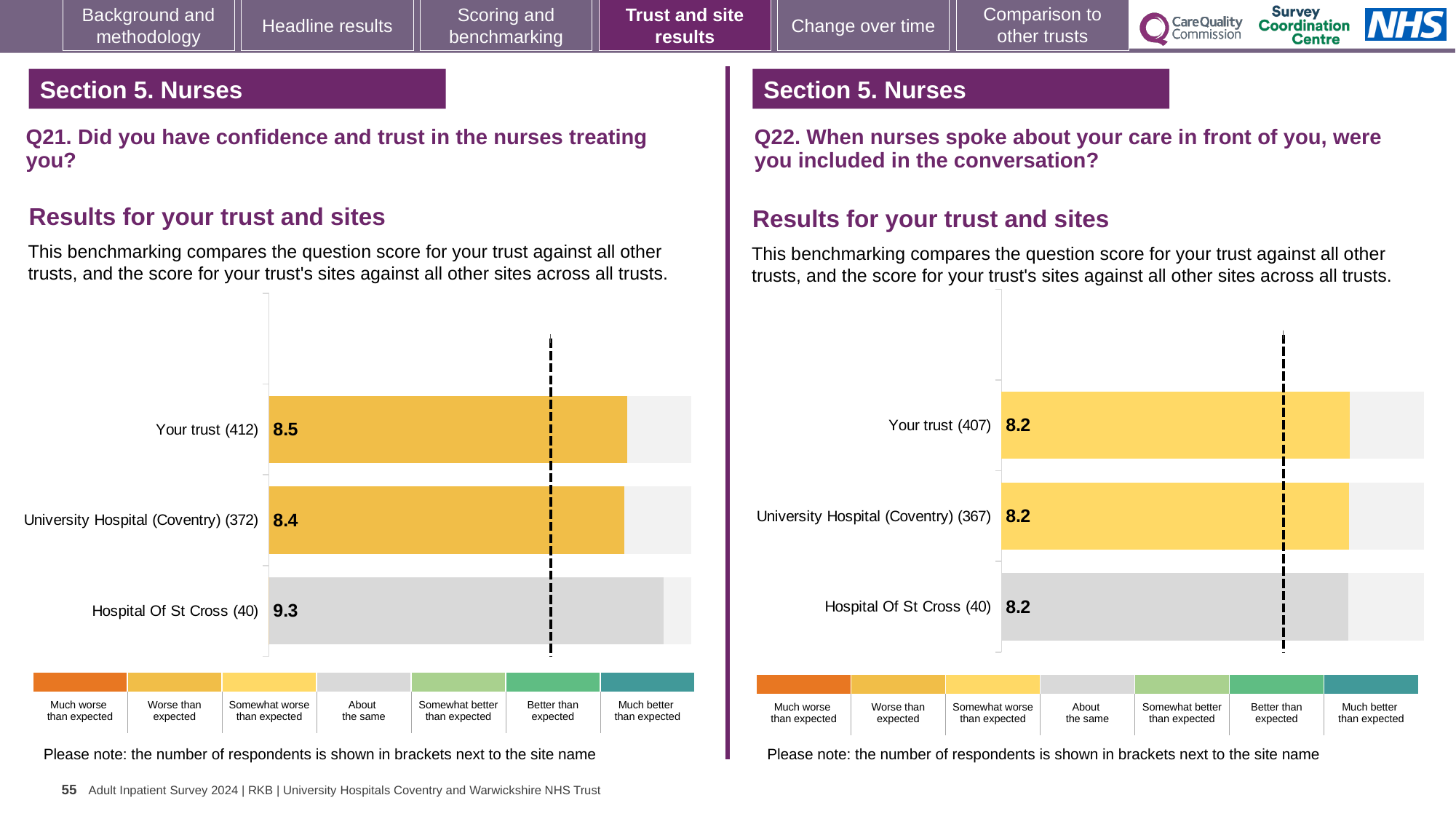
In the Q21 chart on the left, which site or trust has the highest score? Hospital Of St Cross (40) In the Q22 chart on the right, what is the score for Hospital Of St Cross (40)? 8.2 In the Q22 chart on the right, what is the score for Your trust (407)? 8.2 In the Q21 chart on the left, what colour category does the Hospital Of St Cross (40) bar fall into according to the legend? About the same In the Q21 chart on the left, what is the difference between the score for Hospital Of St Cross (40) and the score for Your trust (412)? 0.8 In the Q21 chart on the left, what is the score for Your trust (412)? 8.5 In the Q21 chart on the left, which has the larger score: Your trust (412) or University Hospital (Coventry) (372)? Your trust (412) In the Q21 chart on the left, which site or trust has the lowest score? University Hospital (Coventry) (372) How many bars are plotted in the Q22 chart on the right? 3 In the Q21 chart on the left, what is the score for University Hospital (Coventry) (372)? 8.4 What kind of chart is used in the Q21 chart on the left? Bar chart In the Q21 chart on the left, what is the score for Hospital Of St Cross (40)? 9.3